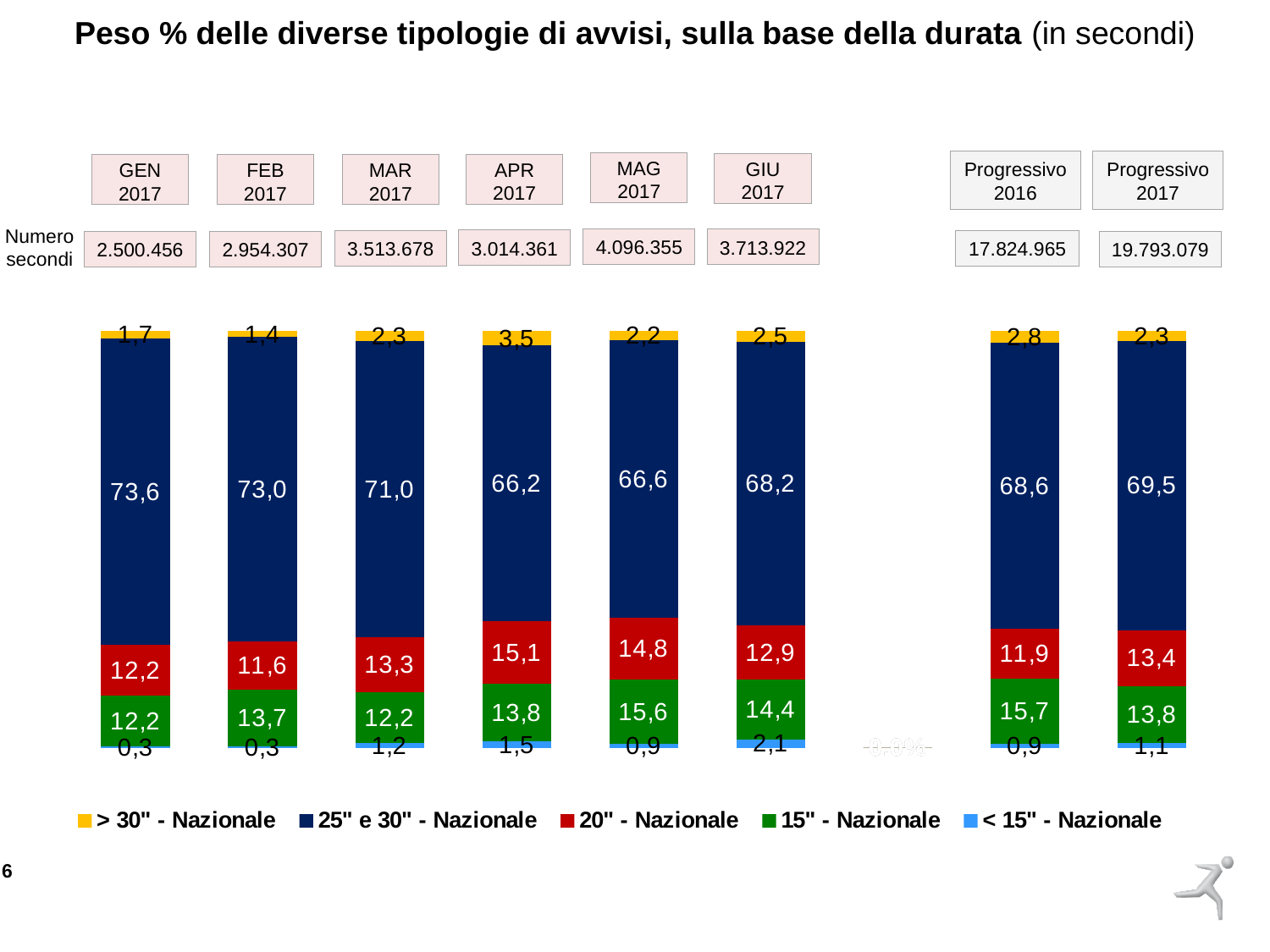
How many bars are plotted in the chart? 8 Which category has the highest value for the 25" e 30" - Nazionale series? GEN 2017 What kind of chart is shown on the slide? Stacked bar chart Does the 25" e 30" - Nazionale value rise or fall from GEN 2017 to APR 2017? Fall Which is larger, the 20" - Nazionale value for MAR 2017 or for GIU 2017? MAR 2017 What is the difference between the 25" e 30" - Nazionale values for GEN 2017 and APR 2017? 7,4 What is the value of the 15" - Nazionale series for Progressivo 2017? 13,8 What is the value of the 25" e 30" - Nazionale series for GEN 2017? 73,6 Which category has the highest value for the > 30" - Nazionale series? APR 2017 What is the value of the 20" - Nazionale series for APR 2017? 15,1 How many series does the legend list? 5 What is the value of the < 15" - Nazionale series for GIU 2017? 2,1